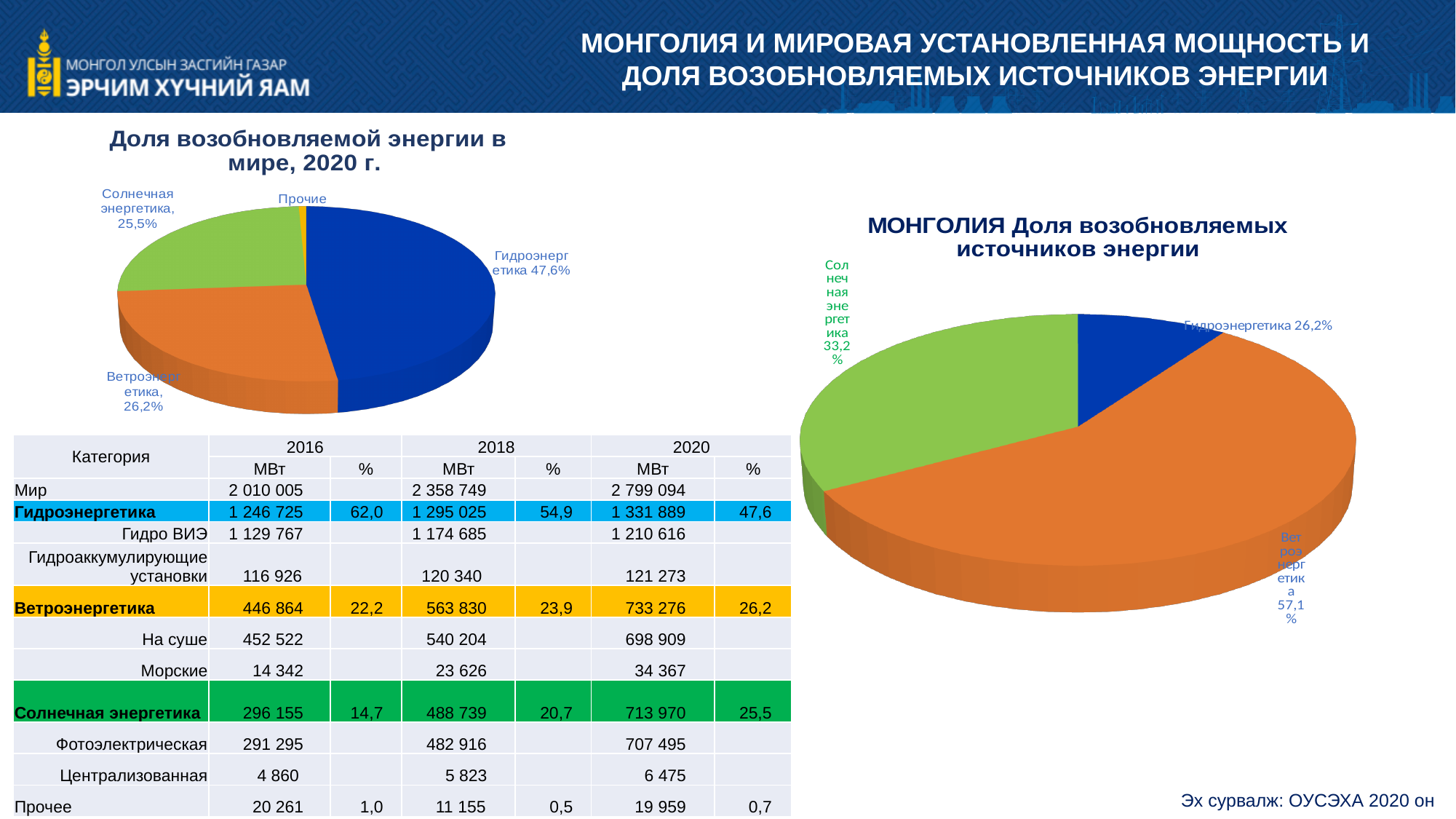
In the chart titled "МОНГОЛИЯ Доля возобновляемых источников энергии", what share does Ветроэнергетика have? 57,1% In the chart titled "Доля возобновляемой энергии в мире, 2020 г.", what share does Ветроэнергетика have? 26,2% In the chart titled "Доля возобновляемой энергии в мире, 2020 г.", how many slices does the pie have? 4 In the chart titled "Доля возобновляемой энергии в мире, 2020 г.", what share does Солнечная энергетика have? 25,5% In the chart titled "Доля возобновляемой энергии в мире, 2020 г.", which slice is the largest? Гидроэнергетика In the chart titled "Доля возобновляемой энергии в мире, 2020 г.", which slice is the smallest? Прочие In the chart titled "Доля возобновляемой энергии в мире, 2020 г.", what is the difference between the Гидроэнергетика and Ветроэнергетика shares? 21,4% What type of chart is the one titled "МОНГОЛИЯ Доля возобновляемых источников энергии"? Pie chart In the chart titled "Доля возобновляемой энергии в мире, 2020 г.", what share does Гидроэнергетика have? 47,6% In the chart titled "МОНГОЛИЯ Доля возобновляемых источников энергии", what share does Солнечная энергетика have? 33,2% In the chart titled "МОНГОЛИЯ Доля возобновляемых источников энергии", which slice is the largest? Ветроэнергетика